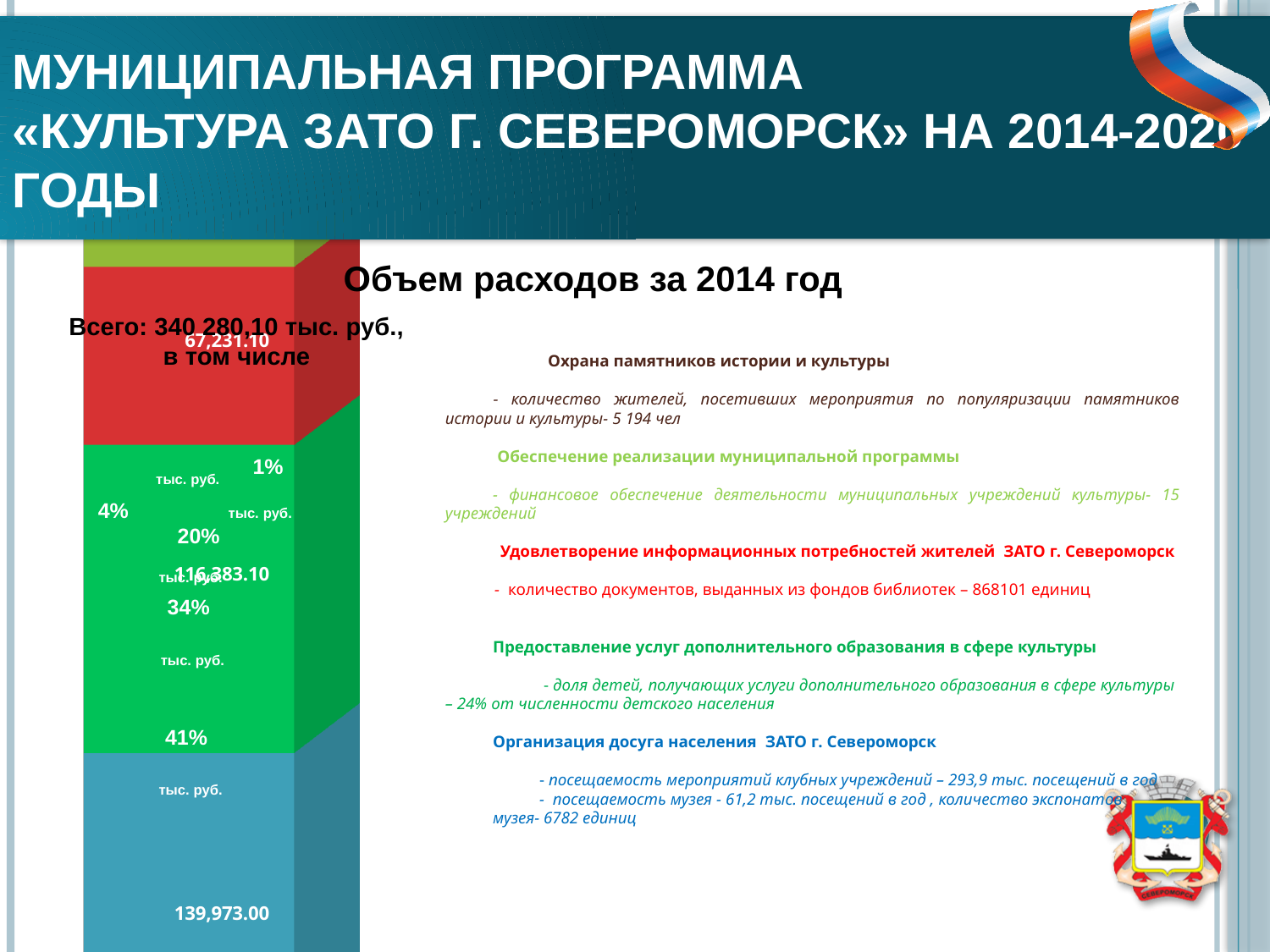
What is the largest percentage label shown on the chart? 41% What total amount of expenses is stated above the chart? 340 280,10 тыс. руб. What is the smallest value printed as a data label on the chart? 67,231.10 What kind of chart is shown on the slide? Bar chart (stacked) What unit is repeated in the labels on the chart? тыс. руб. What is the title of the chart on the slide? Объем расходов за 2014 год Which printed value on the chart is larger: 139,973.00 or 67,231.10? 139,973.00 What is the difference between the data labels 116,383.10 and 67,231.10 on the chart? 49,152.00 What is the largest value printed as a data label on the chart? 139,973.00 What is the difference between the data labels 139,973.00 and 116,383.10 on the chart? 23,589.90 Is the value 116,383.10 printed on the chart greater or less than 100,000? greater What is the smallest percentage label shown on the chart? 1%